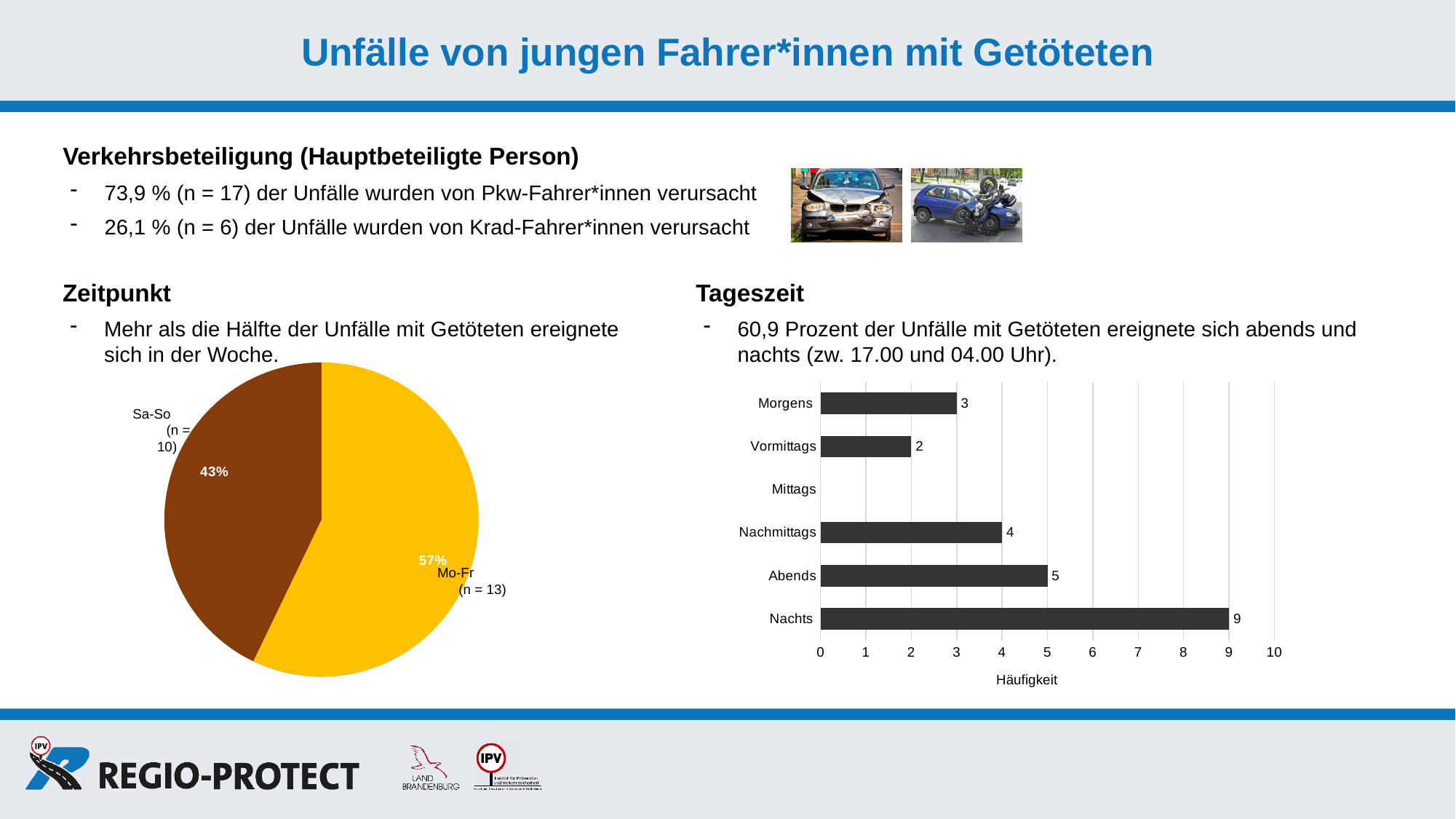
What is the x-axis label of the bar chart under 'Tageszeit'? Häufigkeit In the bar chart under 'Tageszeit', what is the value for Nachts? 9 In the pie chart under 'Zeitpunkt', what is the n value shown for Sa-So? n = 10 How many categories are shown on the y axis of the bar chart under 'Tageszeit'? 6 In the bar chart under 'Tageszeit', which category has the highest value? Nachts In the pie chart under 'Zeitpunkt', which slice is larger, Mo-Fr or Sa-So? Mo-Fr In the bar chart under 'Tageszeit', what is the value for Abends? 5 In the bar chart under 'Tageszeit', what is the value for Vormittags? 2 In the bar chart under 'Tageszeit', what is the difference between the values for Nachts and Morgens? 6 In the bar chart under 'Tageszeit', which is larger, the value for Nachmittags or the value for Vormittags? Nachmittags What kind of chart is shown under 'Tageszeit'? bar chart In the pie chart under 'Zeitpunkt', what share does the Mo-Fr slice have? 57%